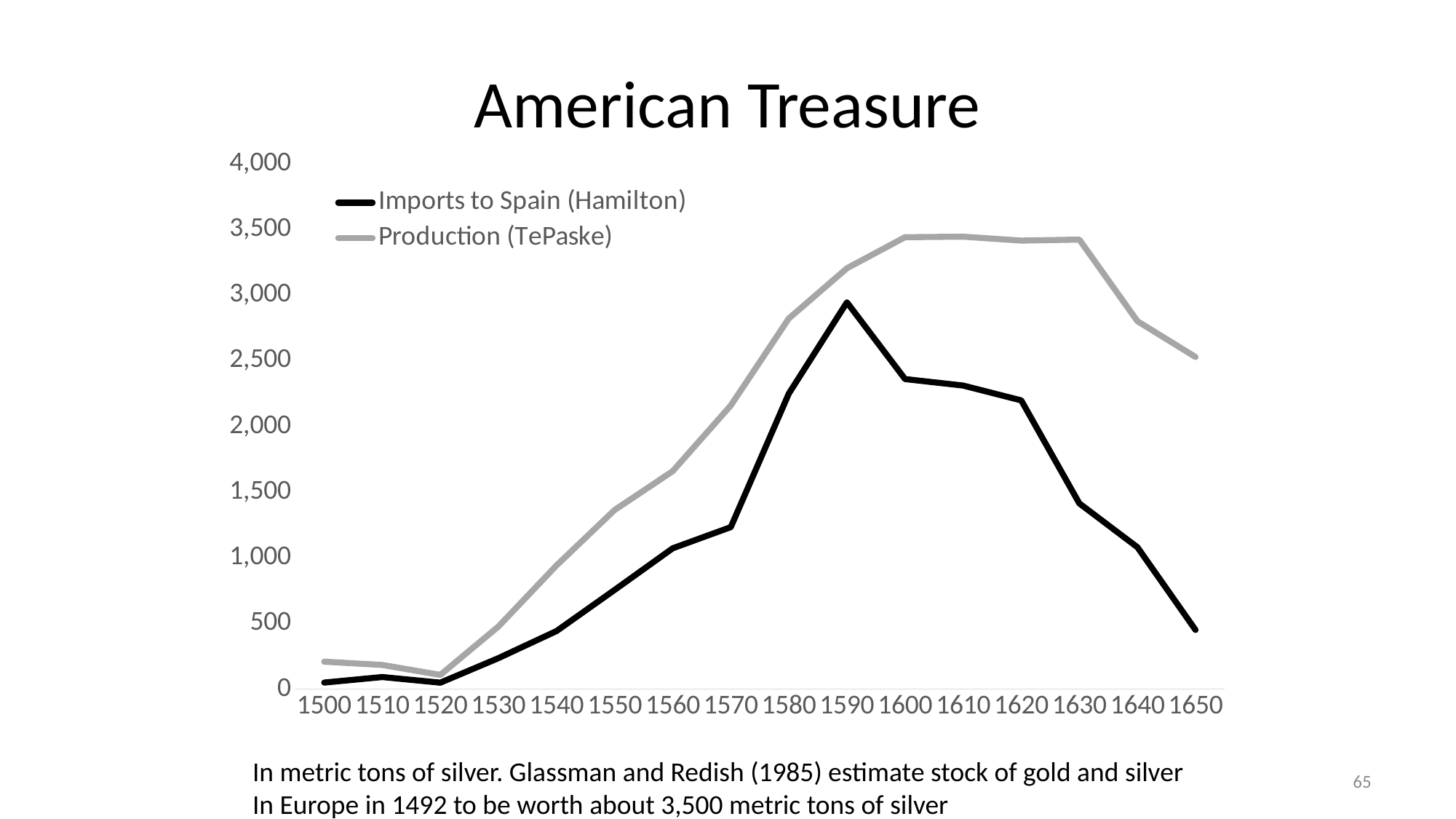
In which year does the Imports to Spain (Hamilton) series reach its highest value? 1590 What kind of chart is shown on the slide? line chart How many years are marked along the x axis? 16 Does the Imports to Spain (Hamilton) series rise or fall between 1590 and 1650? fall Is the value for Production (TePaske) in 1650 greater or less than 2,000? greater Is the value for Imports to Spain (Hamilton) in 1590 greater or less than 2,500? greater Is the value for Production (TePaske) in 1500 greater or less than 500? less How many series does the legend list? 2 In 1600, which series has the higher value, Imports to Spain (Hamilton) or Production (TePaske)? Production (TePaske) What is the title of the chart? American Treasure